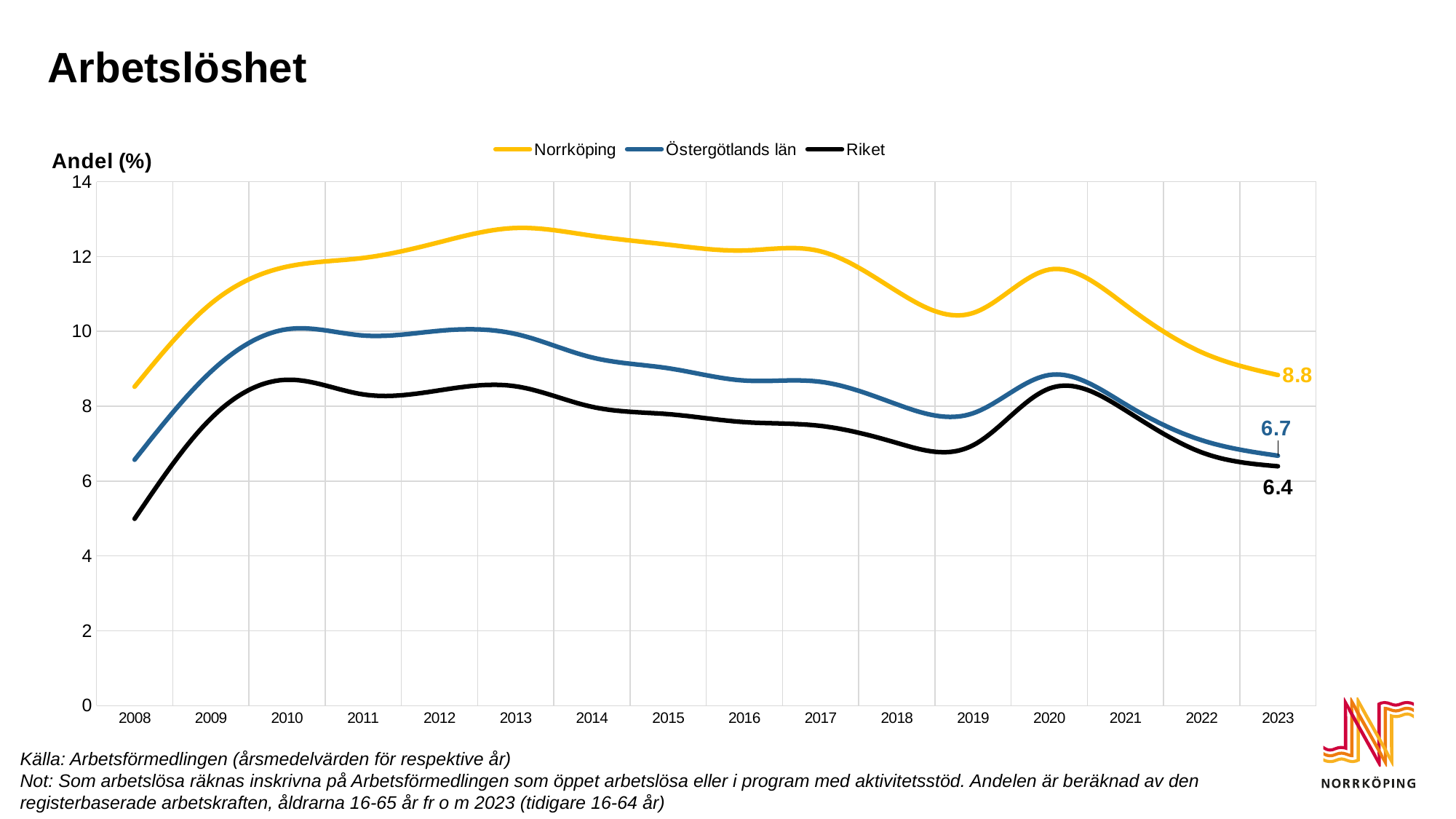
What is the value for Östergötlands län in 2023? 6.7 What is the difference between the Norrköping and Riket values in 2023? 2.4 Is the value for Riket in 2008 greater or less than 6? less How many series does the legend list? 3 Which series has the lowest value in 2023? Riket What kind of chart is shown on the slide? Line chart What is the value for Riket in 2023? 6.4 Is the value for Norrköping in 2013 greater or less than 12? greater Which series has the highest value in 2023? Norrköping How many years are shown on the x axis? 16 What is the difference between the Östergötlands län and Riket values in 2023? 0.3 What is the value for Norrköping in 2023? 8.8